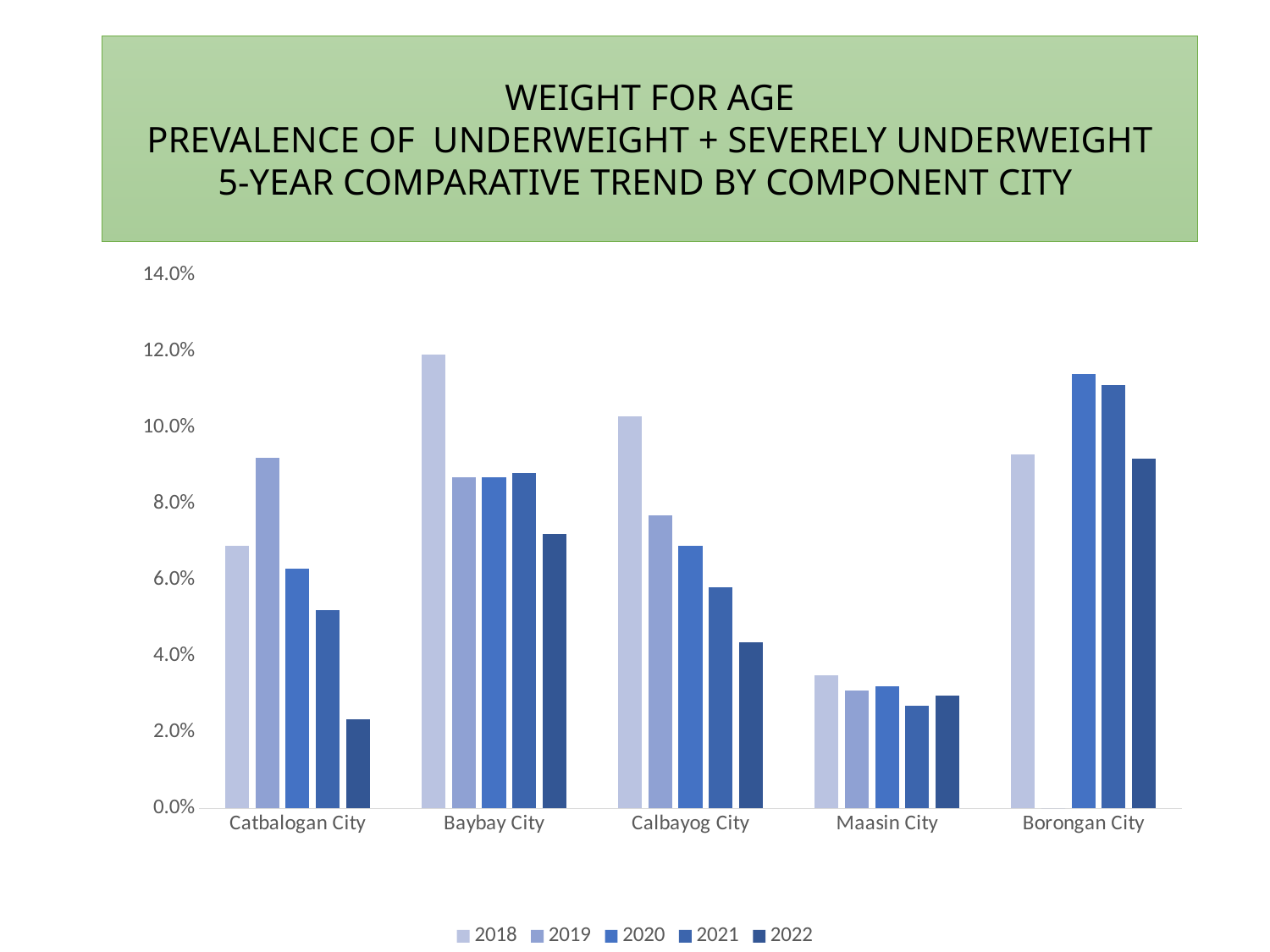
Do the values for Calbayog City rise or fall from 2018 to 2022? fall What kind of chart is shown on the slide? bar chart Is the 2022 value for Catbalogan City greater or less than 4.0%? less Is the 2018 value for Baybay City greater or less than 10.0%? greater Which city has the lowest value for 2022? Catbalogan City Which city has the highest value for 2018? Baybay City Which is larger, the 2018 value for Calbayog City or the 2018 value for Borongan City? Calbayog City How many component cities are shown on the x axis? 5 What is the first entry in the legend? 2018 Which city has the highest value for 2022? Borongan City How many series does the legend list? 5 Is the 2018 value for Maasin City greater or less than 4.0%? less